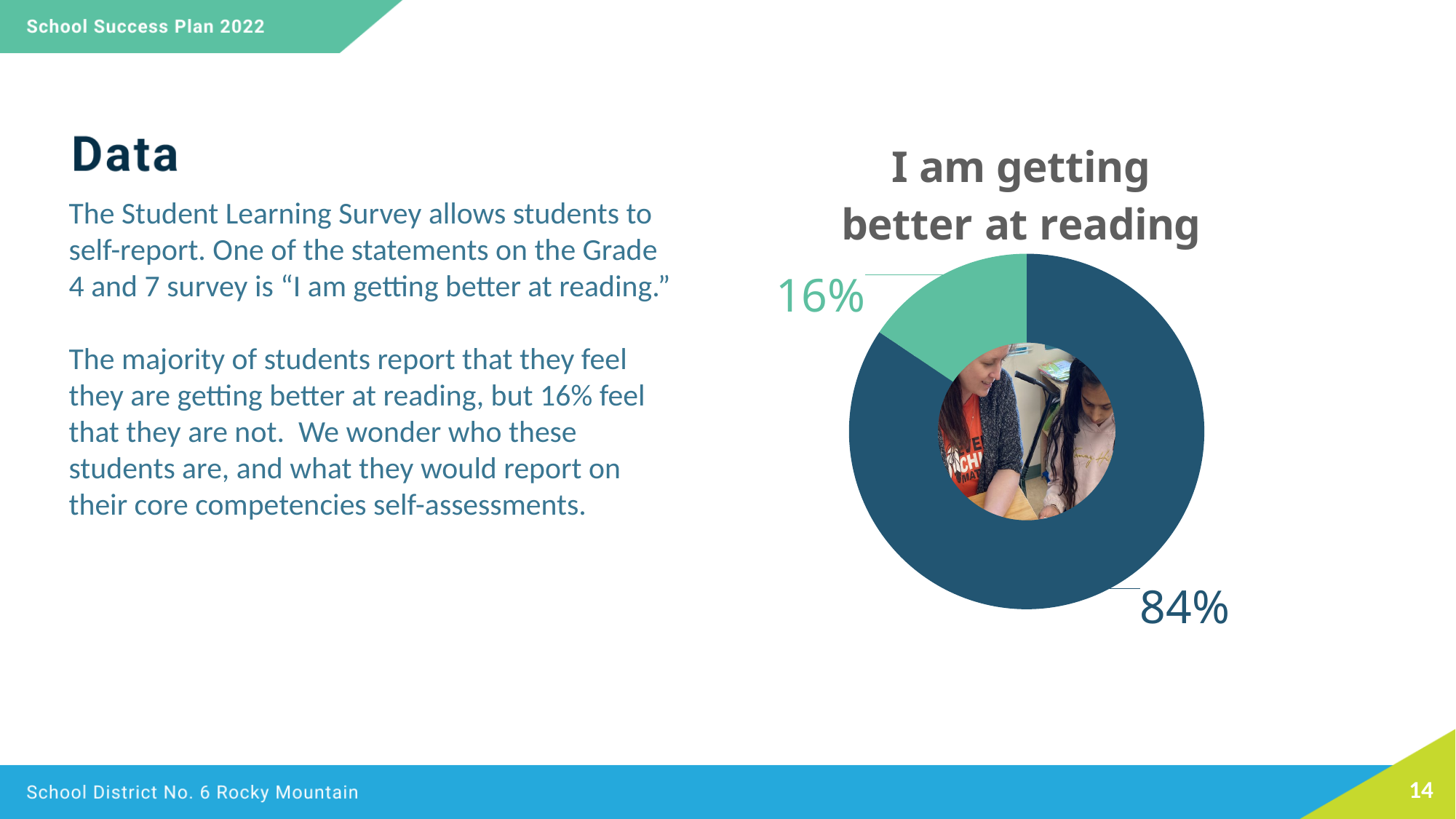
What share of the pie does the dark blue slice represent? 84% What do the two slice percentages in the pie chart add up to? 100% What percentage is shown for the smallest slice of the pie chart? 16% What percentage is shown for the largest slice of the pie chart? 84% How many slices does the pie chart have? 2 What kind of chart is shown on the slide? doughnut chart What colour is the slice labelled 16%? green Which slice is larger, the dark blue slice or the green slice? dark blue Is the value of the dark blue slice greater or less than 50%? greater What is the difference in percentage points between the two slices of the pie chart? 68 What is the title of the chart? I am getting better at reading What share of the pie does the green slice represent? 16%